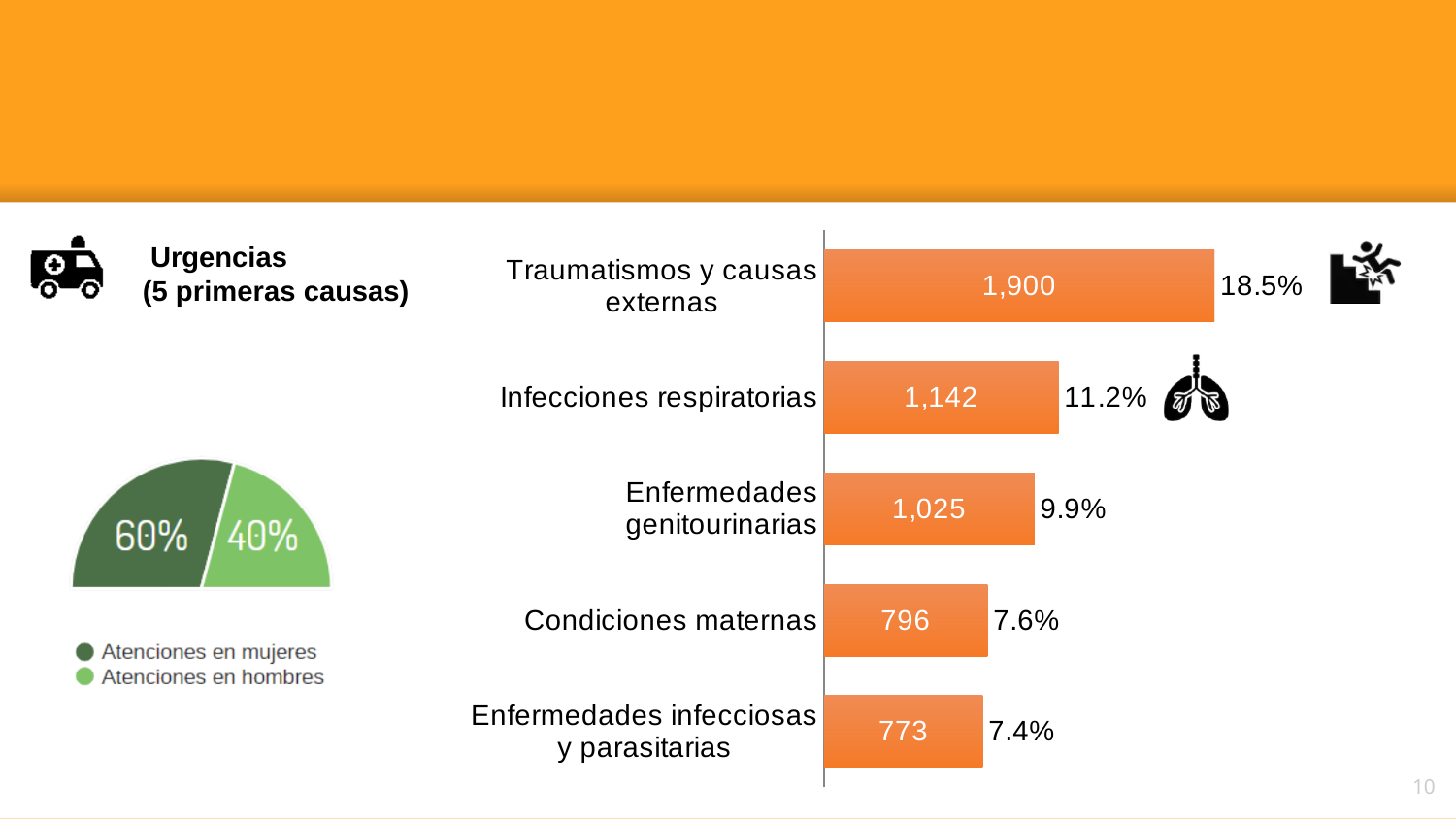
In the bar chart, which category has the highest value? Traumatismos y causas externas In the bar chart, what is the difference between the values for Traumatismos y causas externas and Infecciones respiratorias? 758 In the semicircle chart on the left, what share is Atenciones en mujeres? 60% In the bar chart, what is the value for Traumatismos y causas externas? 1,900 In the bar chart, what is the value for Condiciones maternas? 796 In the bar chart, what is the value for Infecciones respiratorias? 1,142 In the bar chart, which category has the lowest value? Enfermedades infecciosas y parasitarias How many categories does the bar chart show? 5 In the semicircle chart on the left, what share is Atenciones en hombres? 40% In the bar chart, what percentage is shown next to Enfermedades genitourinarias? 9.9% In the bar chart, which is larger: the value for Enfermedades genitourinarias or Condiciones maternas? Enfermedades genitourinarias What kind of chart is the chart on the right of the slide? Bar chart